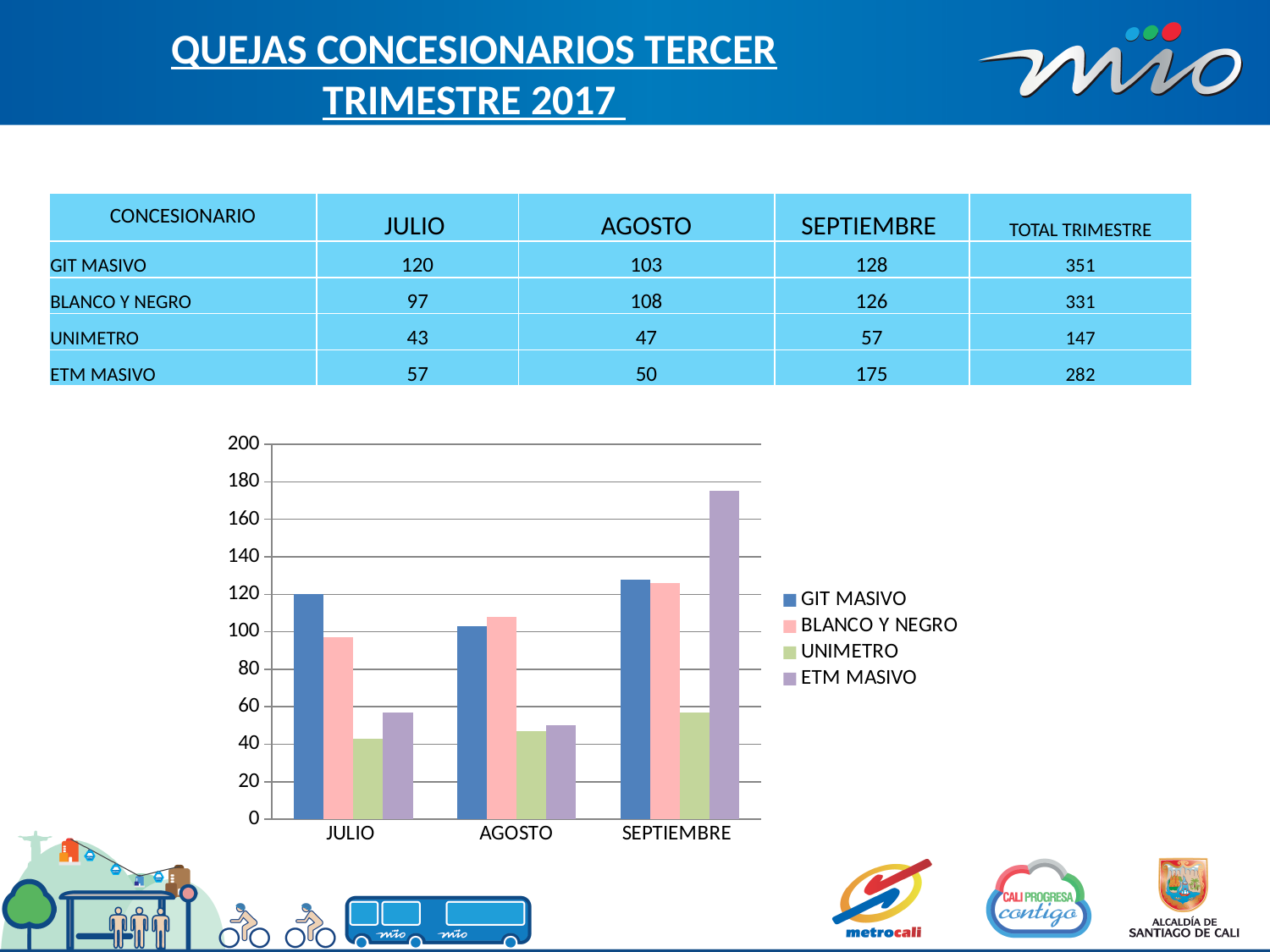
Do the UNIMETRO values rise or fall from JULIO to SEPTIEMBRE? rise Is the value for ETM MASIVO in SEPTIEMBRE greater or less than 160? greater How many series does the chart legend list? 4 Which series has the highest bar in SEPTIEMBRE? ETM MASIVO What is the value for ETM MASIVO in SEPTIEMBRE? 175 How many month categories are shown on the x axis of the chart? 3 What kind of chart is shown on the slide? bar chart What is the difference between the ETM MASIVO value in SEPTIEMBRE and in AGOSTO? 125 What is the value for UNIMETRO in AGOSTO? 47 Which series has the lowest bar in JULIO? UNIMETRO Which is larger in AGOSTO, GIT MASIVO or BLANCO Y NEGRO? BLANCO Y NEGRO What is the value for GIT MASIVO in JULIO? 120